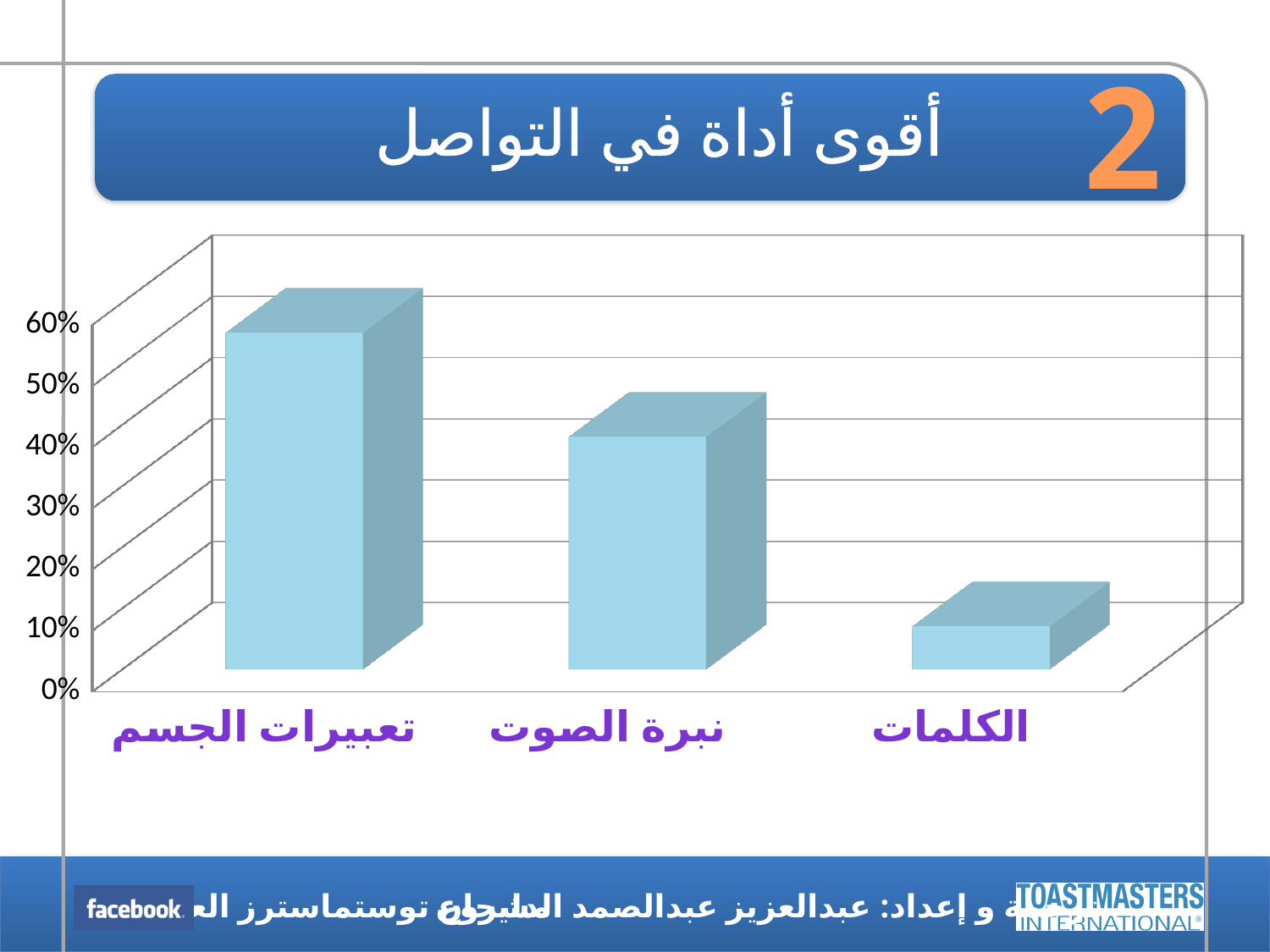
Which category has the highest bar in the chart? تعبيرات الجسم Is the value for نبرة الصوت greater or less than 50%? less Do the bar values rise or fall from left to right along the x axis? fall Which is larger, the value for تعبيرات الجسم or the value for نبرة الصوت? تعبيرات الجسم Is the value for تعبيرات الجسم greater or less than 50%? greater Which category has the lowest bar in the chart? الكلمات What kind of chart is shown on the slide? bar chart Is the value for نبرة الصوت greater or less than 30%? greater Which is larger, the value for نبرة الصوت or the value for الكلمات? نبرة الصوت How many categories are shown on the x axis of the chart? 3 What is the title shown above the chart? أقوى أداة في التواصل